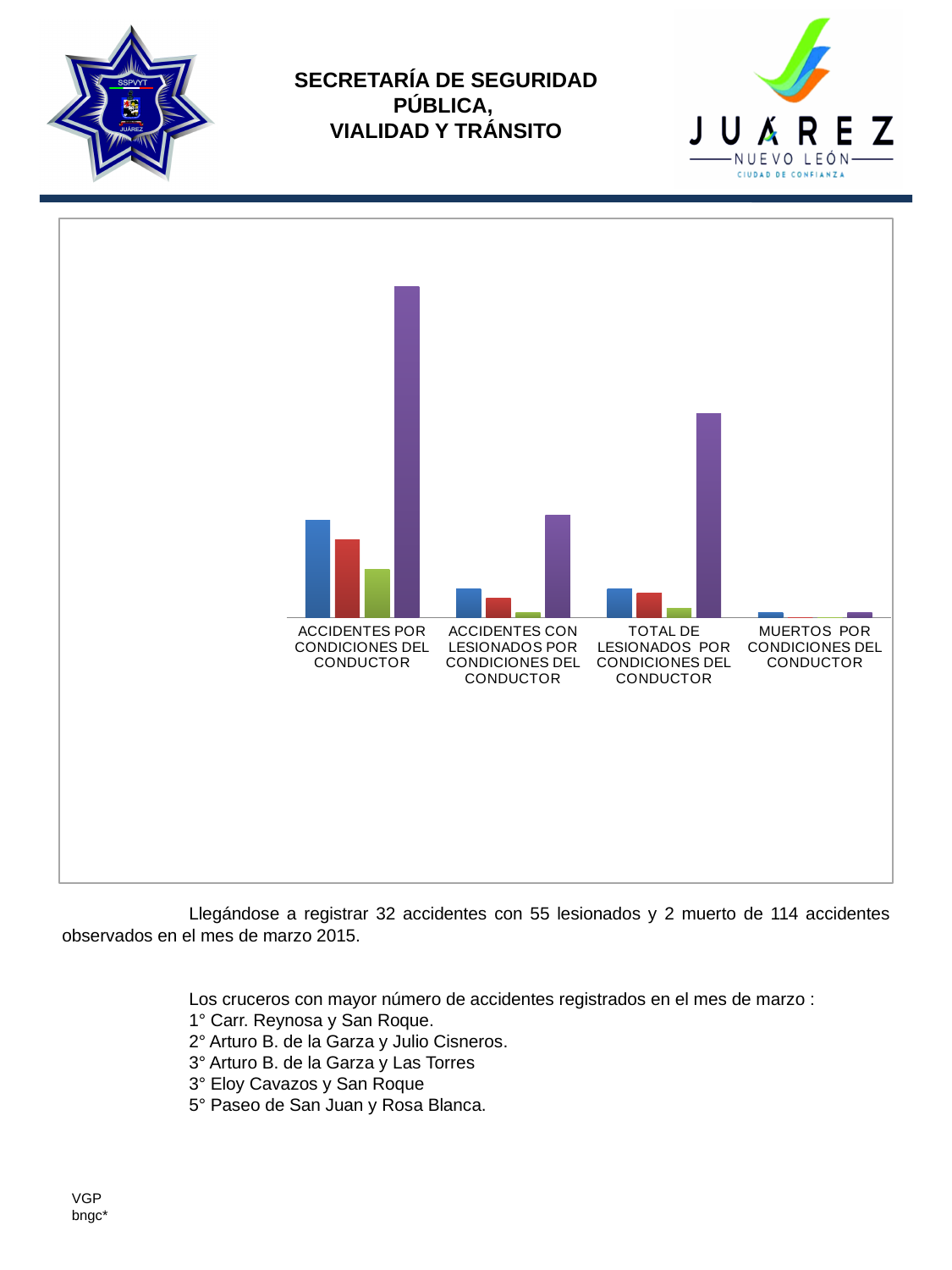
Is the purple bar for TOTAL DE LESIONADOS POR CONDICIONES DEL CONDUCTOR taller or shorter than the purple bar for ACCIDENTES POR CONDICIONES DEL CONDUCTOR? shorter Within the category ACCIDENTES POR CONDICIONES DEL CONDUCTOR, which coloured bar is the tallest? purple Does the chart display a legend? No How many differently coloured bars (series) appear in the category ACCIDENTES POR CONDICIONES DEL CONDUCTOR? 4 Is the purple bar for ACCIDENTES CON LESIONADOS POR CONDICIONES DEL CONDUCTOR taller or shorter than the purple bar for TOTAL DE LESIONADOS POR CONDICIONES DEL CONDUCTOR? shorter How many categories are shown along the x axis of the chart? 4 In the category ACCIDENTES POR CONDICIONES DEL CONDUCTOR, is the blue bar taller or shorter than the red bar? taller Which category has the tallest bar in the chart? ACCIDENTES POR CONDICIONES DEL CONDUCTOR Which category has the lowest bars overall in the chart? MUERTOS POR CONDICIONES DEL CONDUCTOR Which category is the third from the left on the x axis of the chart? TOTAL DE LESIONADOS POR CONDICIONES DEL CONDUCTOR Within the category ACCIDENTES POR CONDICIONES DEL CONDUCTOR, which coloured bar is the shortest? green What kind of chart is shown on the slide? bar chart